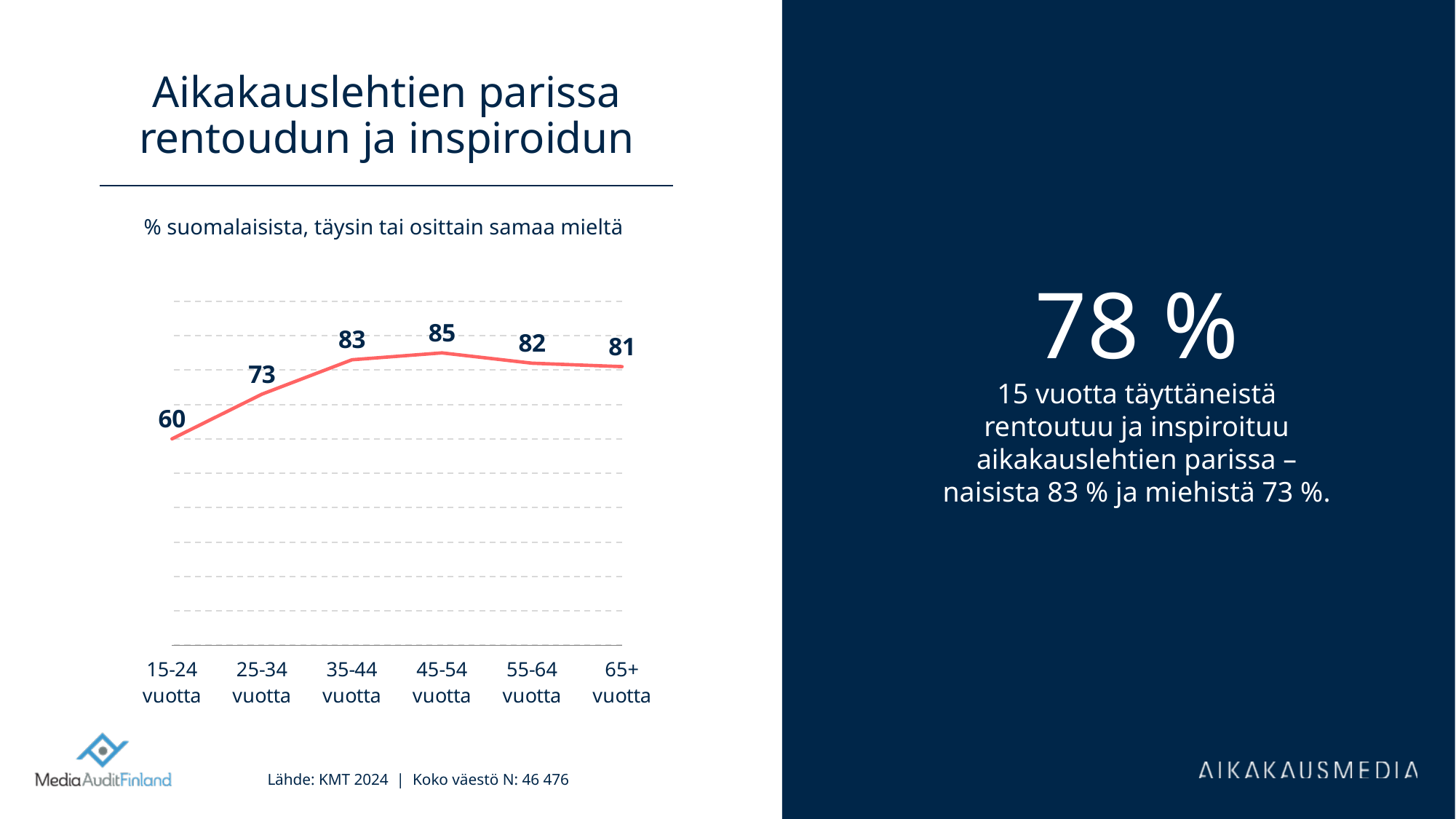
What kind of chart is shown on the slide? line chart How many age groups are plotted on the chart? 6 Do the values rise or fall from the 15-24 vuotta group to the 45-54 vuotta group? rise Which age group has the highest value? 45-54 vuotta What is the value for the 65+ vuotta age group? 81 Which is larger, the value for 35-44 vuotta or the value for 55-64 vuotta? 35-44 vuotta Which age group has the lowest value? 15-24 vuotta What is the difference between the values for 25-34 vuotta and 15-24 vuotta? 13 What is the value for the 15-24 vuotta age group? 60 What is the subtitle shown above the chart? % suomalaisista, täysin tai osittain samaa mieltä What is the difference between the values for 45-54 vuotta and 65+ vuotta? 4 What is the value for the 45-54 vuotta age group? 85